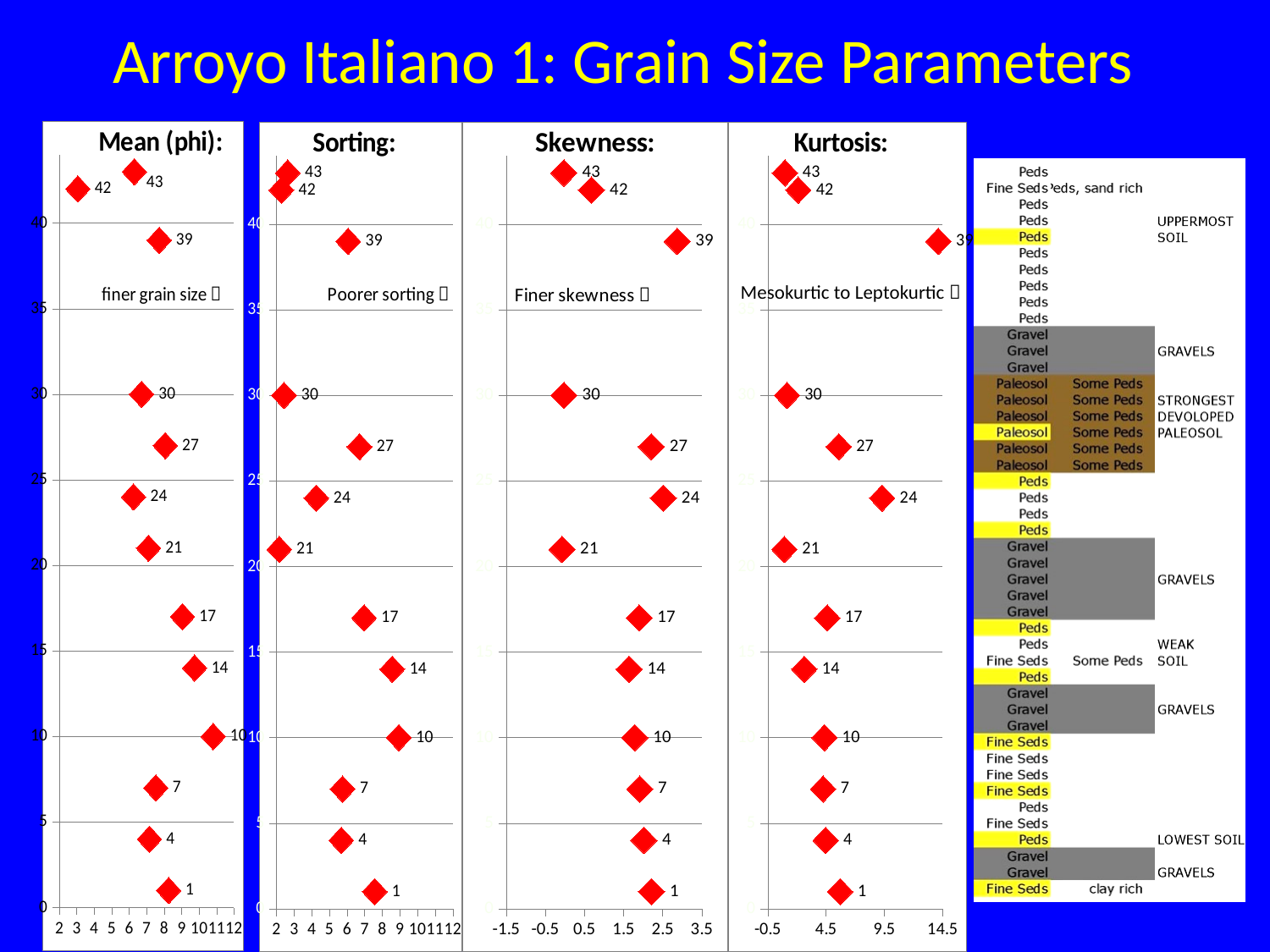
In the Skewness chart, is the value for sample 39 greater or less than 1.5? greater In the Sorting chart, which has the larger value, sample 14 or sample 21? sample 14 How many data points are plotted in the Sorting chart? 13 In the Mean (phi) chart, is the value for sample 10 greater or less than 10? greater In the Mean (phi) chart, which has the larger value, sample 10 or sample 42? sample 10 What are the titles of the four charts on the slide, from left to right? Mean (phi), Sorting, Skewness, Kurtosis In the Kurtosis chart, is the value for sample 39 greater or less than 9.5? greater What kind of chart is the Mean (phi) chart? scatter chart How many data points are plotted in the Kurtosis chart? 13